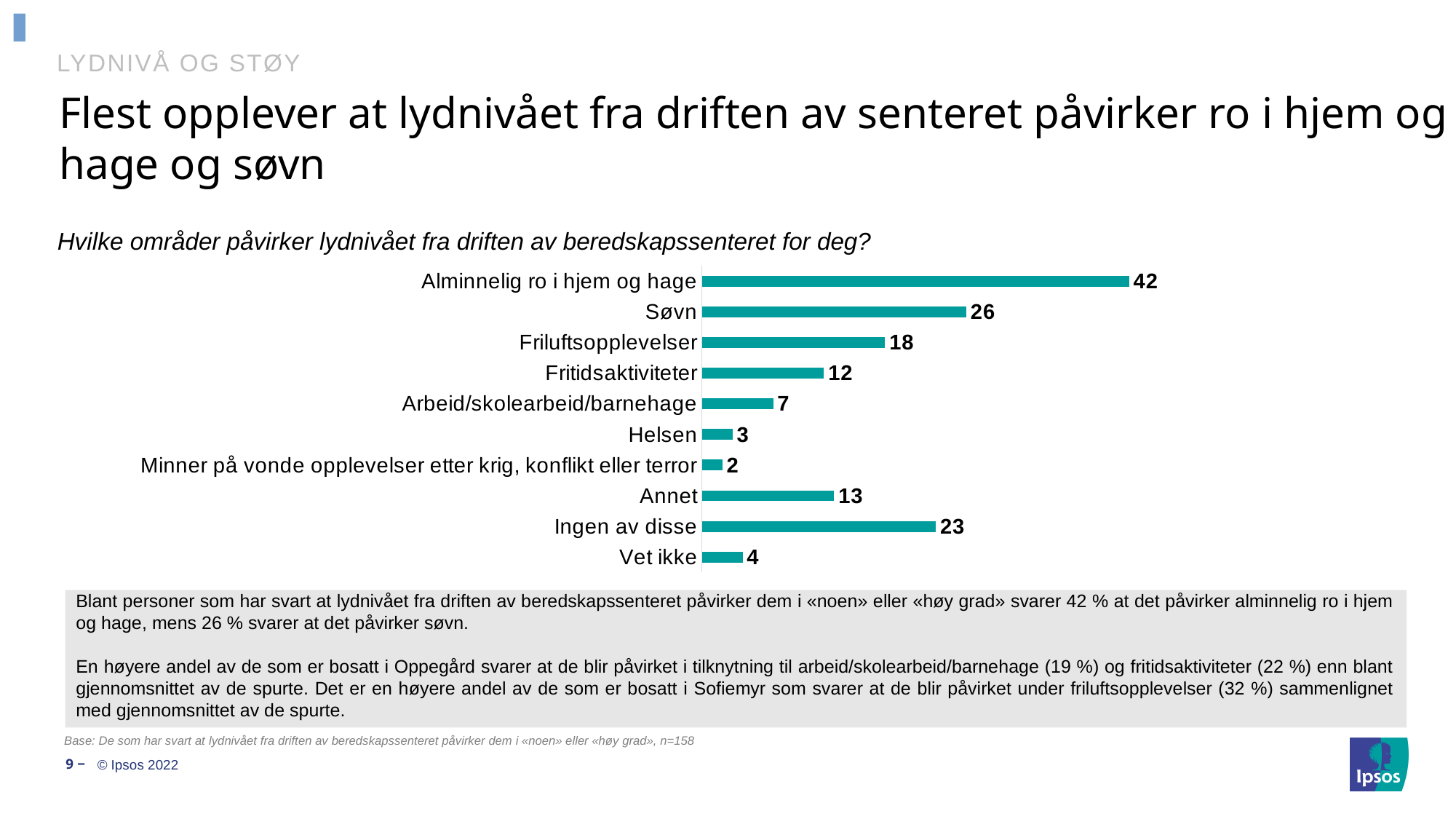
What is the value for Minner på vonde opplevelser etter krig, konflikt eller terror? 2 What is the difference between the values for Alminnelig ro i hjem og hage and Søvn? 16 Which is larger, the value for Annet or the value for Fritidsaktiviteter? Annet How many categories are shown in the chart? 10 What question is the chart based on, as shown above it? Hvilke områder påvirker lydnivået fra driften av beredskapssenteret for deg? Which category has the highest value? Alminnelig ro i hjem og hage What is the difference between the values for Friluftsopplevelser and Fritidsaktiviteter? 6 Which category has the lowest value? Minner på vonde opplevelser etter krig, konflikt eller terror What is the value for Ingen av disse? 23 What is the value for Alminnelig ro i hjem og hage? 42 What is the value for Søvn? 26 What kind of chart is shown on the slide? Bar chart